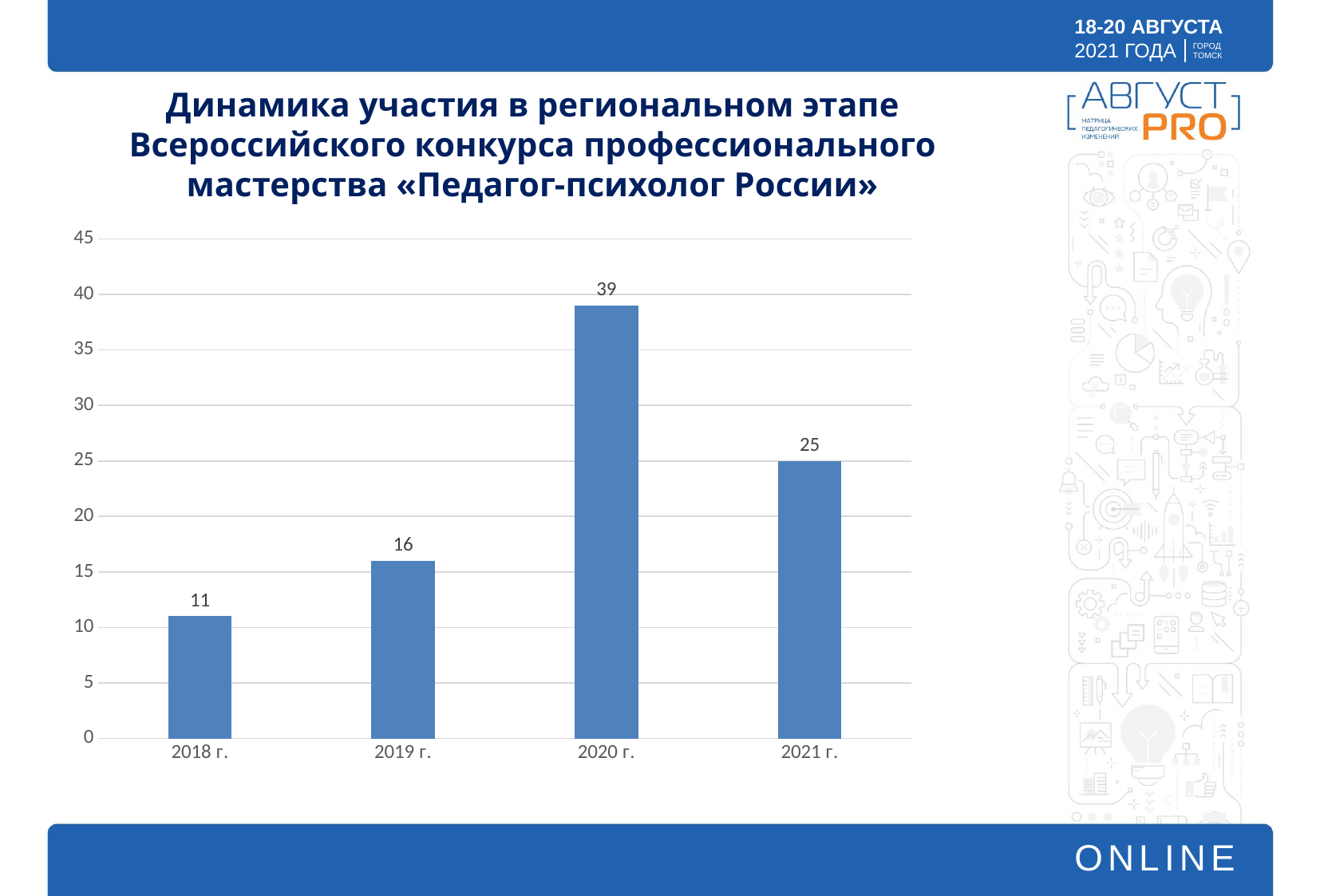
Do the values rise or fall from 2018 г. to 2020 г.? rise What is the value for 2020 г.? 39 How many years are shown on the x axis? 4 What is the difference between the values for 2019 г. and 2018 г.? 5 What is the value for 2018 г.? 11 What is the value for 2019 г.? 16 What is the difference between the values for 2020 г. and 2021 г.? 14 What kind of chart is shown on the slide? bar chart Which is larger, the value for 2021 г. or the value for 2019 г.? 2021 г. Which year has the highest value? 2020 г. What is the value for 2021 г.? 25 Which year has the lowest value? 2018 г.